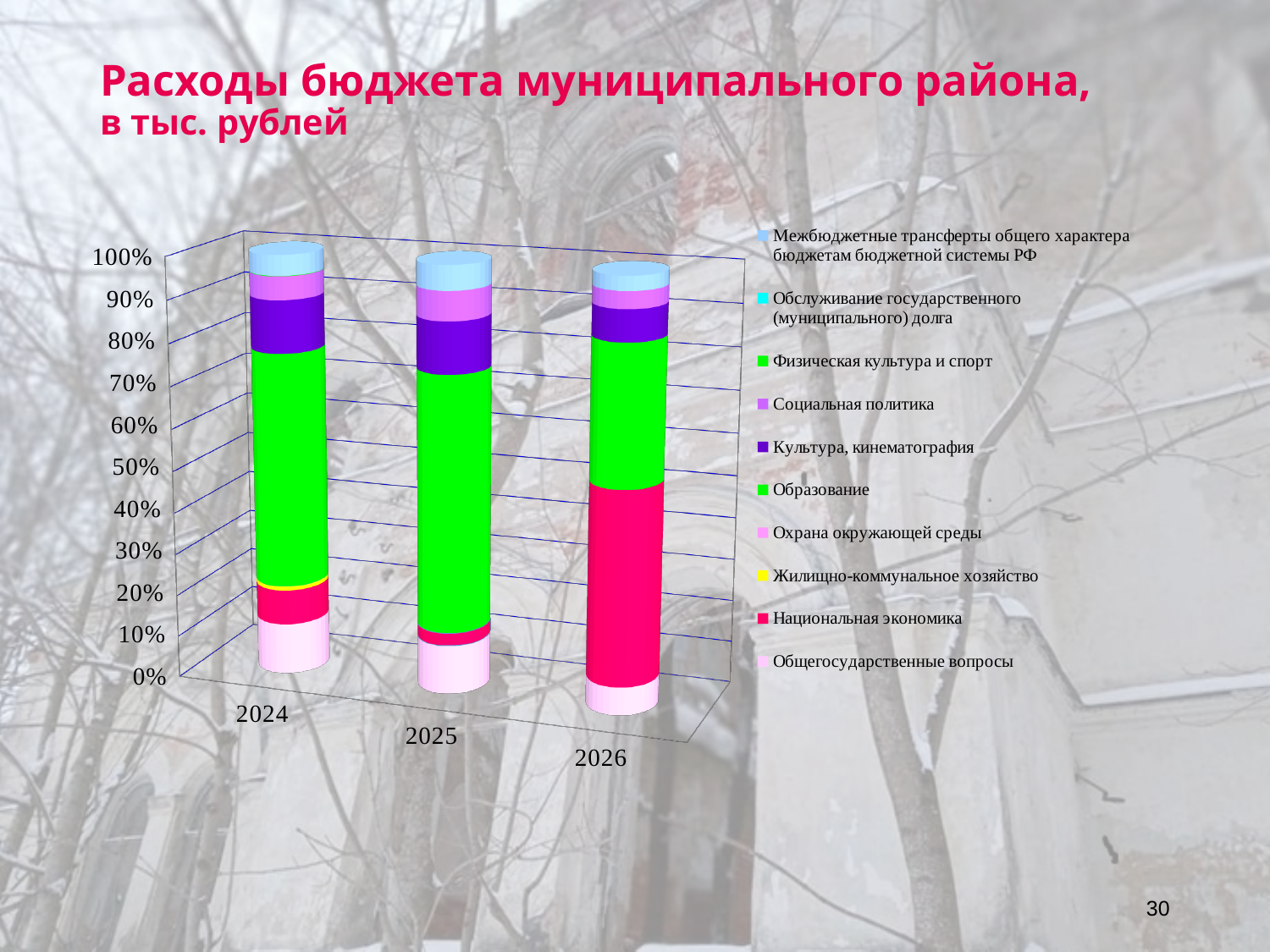
In which year does Образование take the largest share of the bar? 2025 Is the share of Национальная экономика larger in 2024 or in 2026? 2026 How many years (categories) are shown on the x axis of the chart? 3 What kind of chart is shown on the slide? Stacked bar chart In which year does Национальная экономика take the smallest share of the bar? 2025 What is the title of the chart on the slide? Расходы бюджета муниципального района, в тыс. рублей In which year does Национальная экономика take the largest share of the bar? 2026 Does the share of Национальная экономика rise or fall from 2025 to 2026? Rise What is the highest value shown on the vertical axis of the chart? 100% How many series does the chart legend list? 10 Which colour represents Образование in the chart? Green Is the share of Образование larger in 2025 or in 2026? 2025